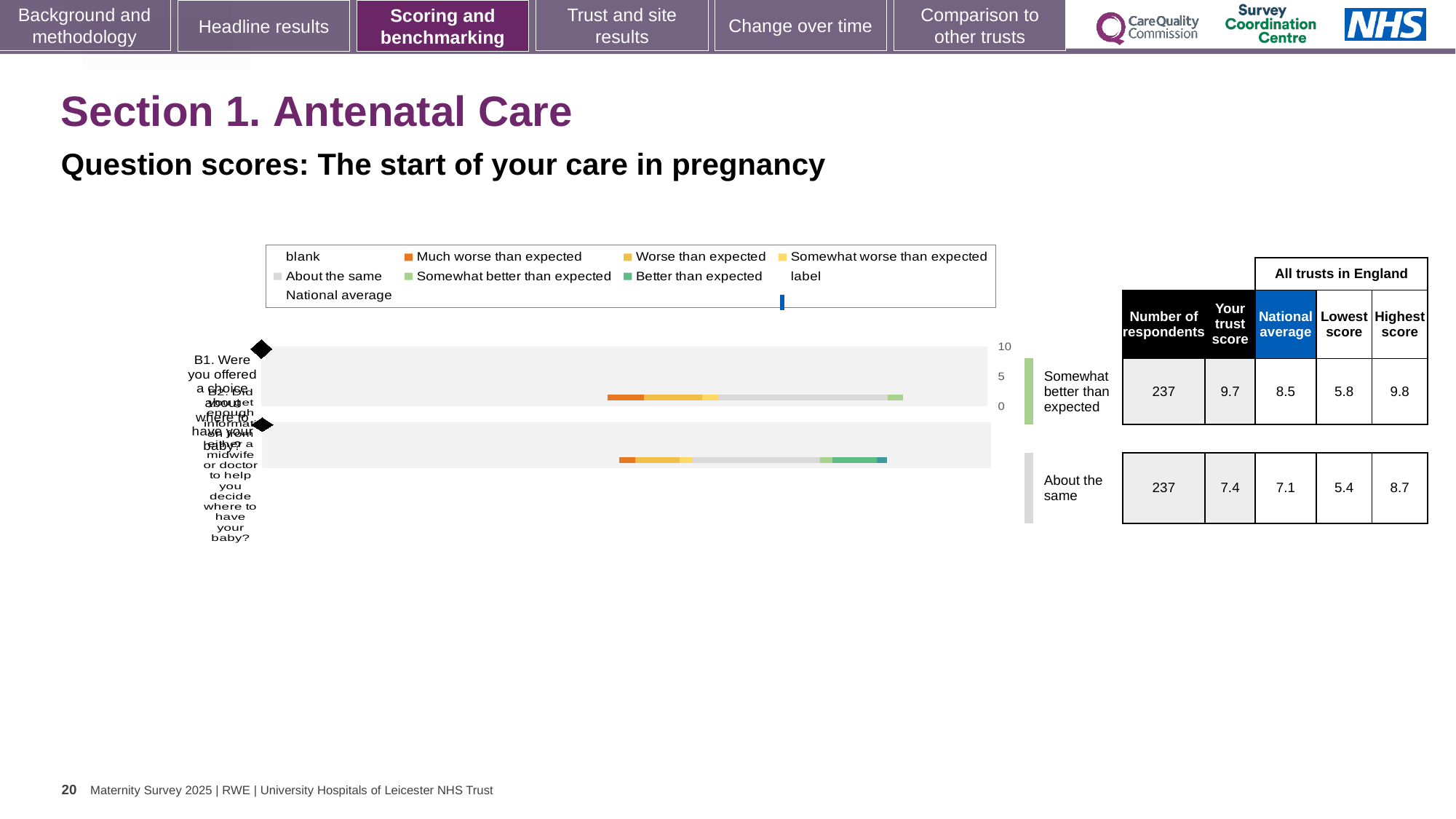
In the table beside the chart, what is the 'Your trust score' for B1 (Were you offered a choice about where to have your baby?)? 9.7 How many respondents are listed for question B1? 237 What kind of chart is shown on the slide? bar chart Which benchmark category is shown for question B1 next to the chart? Somewhat better than expected How many question bars (categories) are plotted in the chart? 2 In the table beside the chart, what is the National average for B2 (Did you get enough information to help you decide where to have your baby?)? 7.1 Which question has the higher 'Your trust score', B1 or B2? B1 What is the Highest score across all trusts in England for question B2? 8.7 What is the Lowest score across all trusts in England for question B1? 5.8 What colour does the legend use for 'Much worse than expected'? orange By how much does the trust score for B1 (9.7) exceed the national average for B1 (8.5)? 1.2